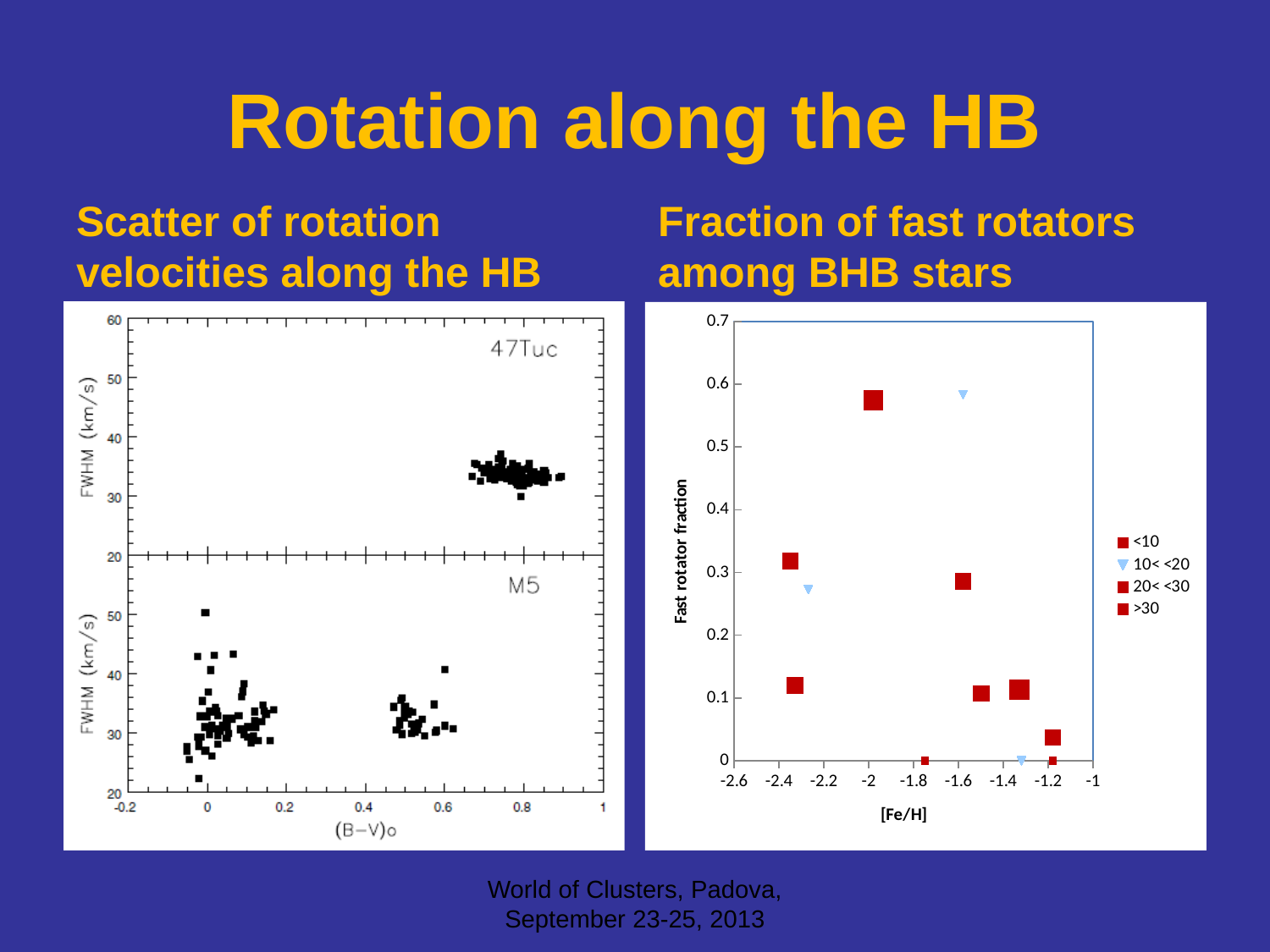
In the left-hand chart, is the FWHM of the 47Tuc group of points greater or less than 40 km/s? less In the right-hand chart, is the fast rotator fraction of the blue triangle plotted near [Fe/H] = -1.6 greater or less than 0.5? greater In the right-hand chart, is the fast rotator fraction of the red square plotted near [Fe/H] = -2 greater or less than 0.5? greater How many blue triangle markers are plotted in the right-hand chart? 3 In the left-hand chart, which two clusters are labelled in the upper and lower panels? 47Tuc and M5 How many entries does the legend of the right-hand chart list? 4 What is the x-axis label of the right-hand chart? [Fe/H] What kind of chart is the right-hand chart, 'Fraction of fast rotators among BHB stars'? scatter plot What is the highest value shown on the y-axis of the right-hand chart? 0.7